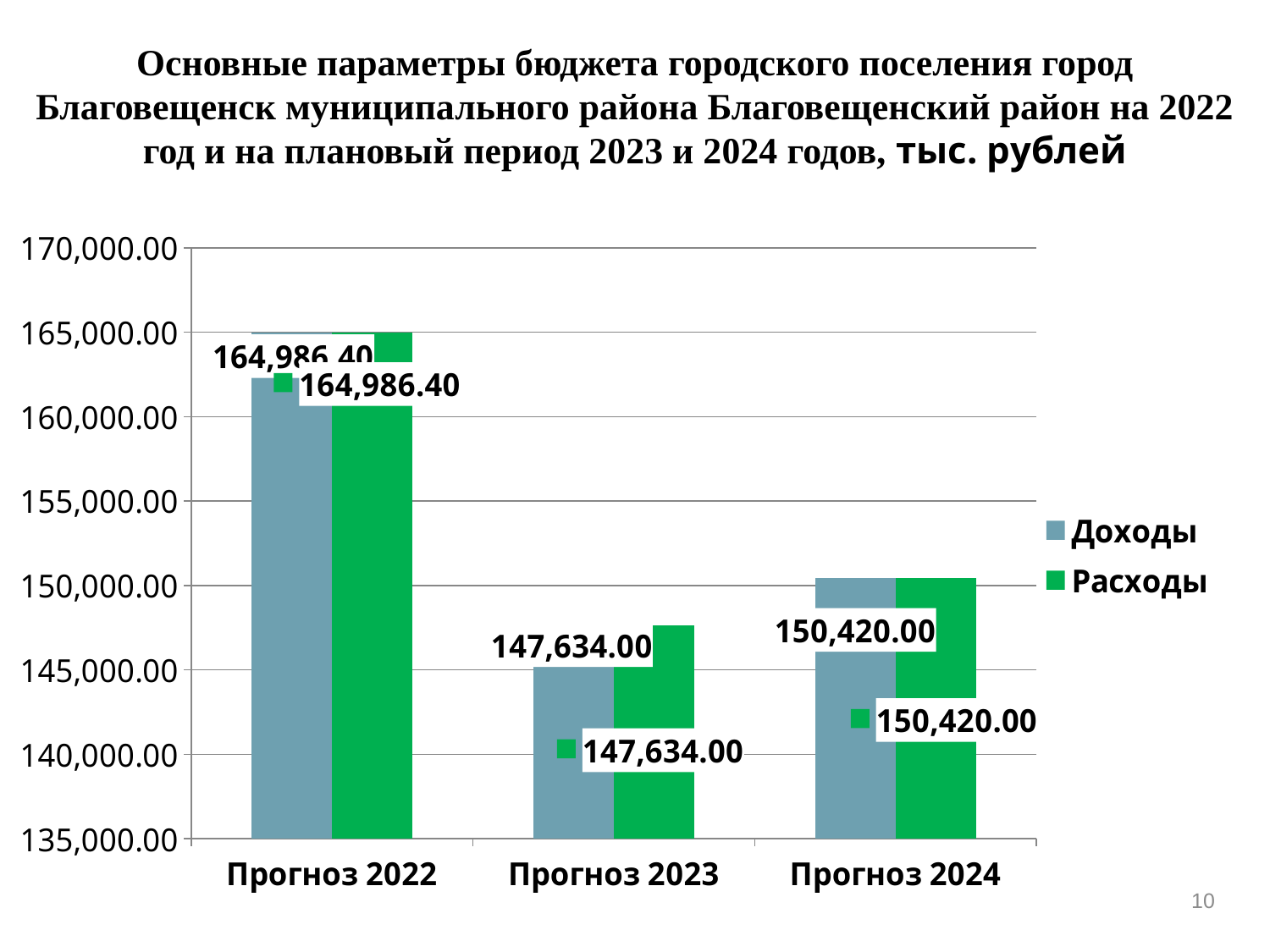
Is the value of Расходы for Прогноз 2022 greater or less than 160,000.00? greater Which category has the lowest value for Расходы? Прогноз 2023 What is the difference between Расходы for Прогноз 2024 and Расходы for Прогноз 2023? 2,786.00 What is the difference between Расходы for Прогноз 2022 and Расходы for Прогноз 2023? 17,352.40 Which category has the highest value for Расходы? Прогноз 2022 How many categories are shown on the x axis? 3 Which is larger: Расходы for Прогноз 2024 or Расходы for Прогноз 2023? Прогноз 2024 What is the value of Расходы for Прогноз 2024? 150,420.00 How many series does the legend list? 2 What kind of chart is shown on the slide? bar chart What is the value of Расходы for Прогноз 2022? 164,986.40 What is the value of Доходы for Прогноз 2023? 147,634.00